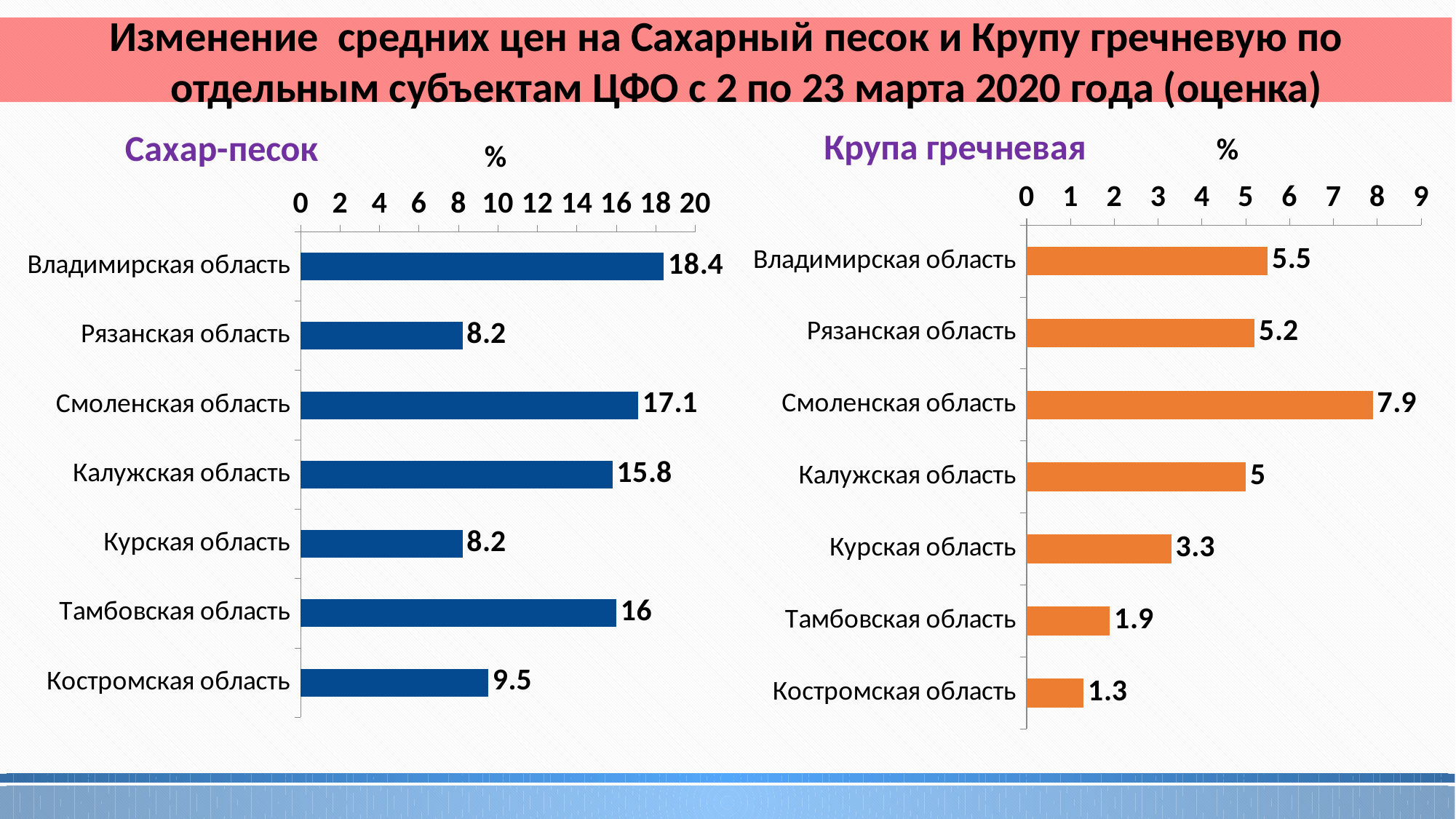
In the Крупа гречневая chart, which region has the highest value? Смоленская область In the Крупа гречневая chart, what is the difference between the values for Владимирская область and Тамбовская область? 3.6 In the Крупа гречневая chart, is the value for Курская область greater or less than 4? less What type of chart is the Крупа гречневая chart? bar chart In the Сахар-песок chart, what is the difference between the values for Владимирская область and Костромская область? 8.9 In the Сахар-песок chart, what is the value for Владимирская область? 18.4 In the Крупа гречневая chart, what is the value for Смоленская область? 7.9 What colour are the bars in the Сахар-песок chart? blue In the Сахар-песок chart, which is larger: the value for Смоленская область or Калужская область? Смоленская область In the Крупа гречневая chart, which region has the lowest value? Костромская область In the Сахар-песок chart, which region has the highest value? Владимирская область